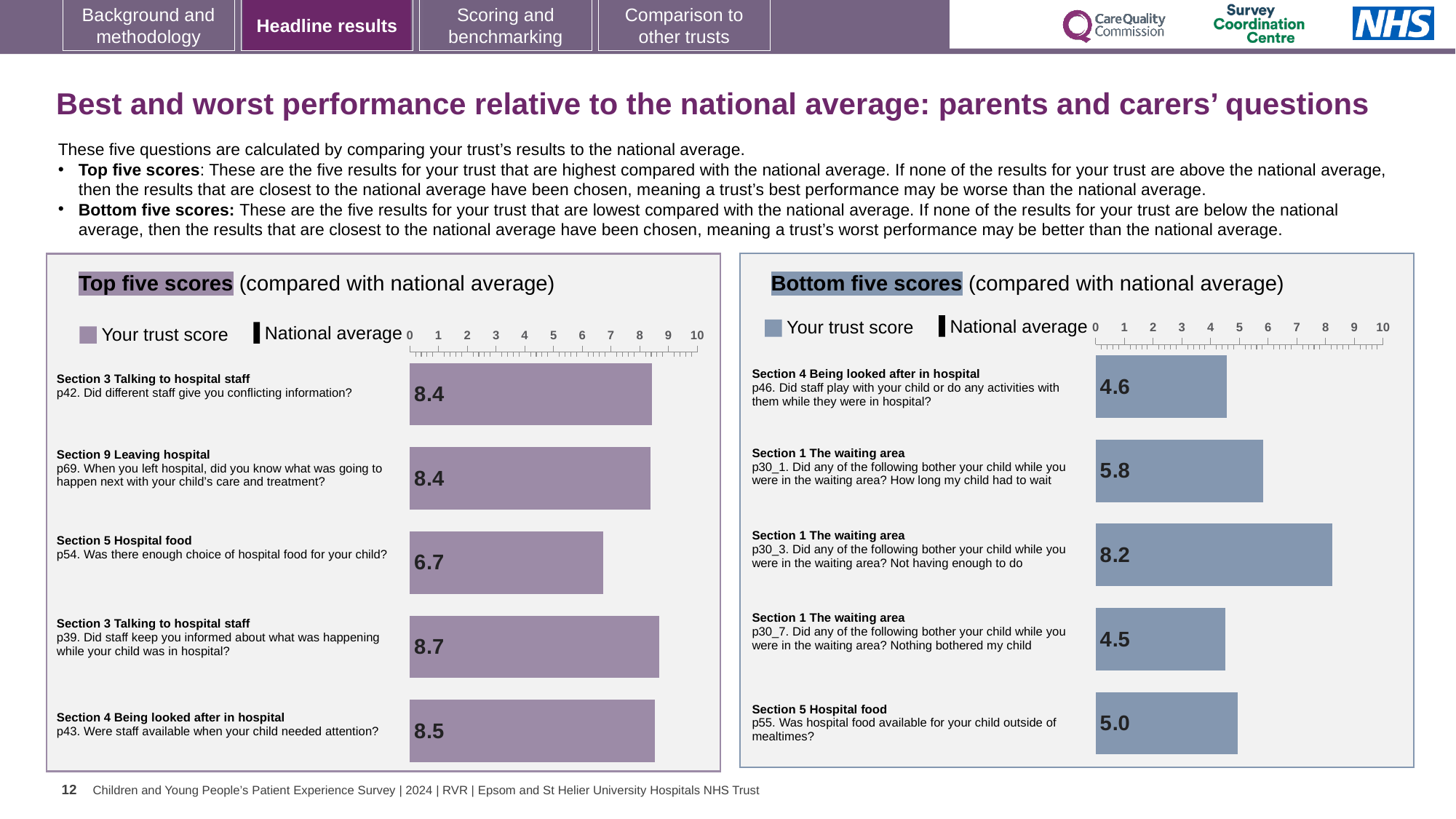
In the Top five scores chart, what is the trust score for p42 'Did different staff give you conflicting information?' 8.4 In the Top five scores chart, which question has the highest trust score? p39. Did staff keep you informed about what was happening while your child was in hospital? In the Top five scores chart, what is the difference between the highest score (p39) and the lowest score (p54)? 2.0 In the Top five scores chart, what is the trust score for p54 'Was there enough choice of hospital food for your child?' 6.7 In the Bottom five scores chart, which question has the lowest trust score? p30_7. Nothing bothered my child What type of chart is used in the Top five scores panel? bar chart In the Bottom five scores chart, what is the difference between the score for p30_3 and the score for p30_7? 3.7 How many questions are shown in the Bottom five scores chart? 5 In the Bottom five scores chart, which has the larger trust score: p30_1 'How long my child had to wait' or p55 'Was hospital food available outside of mealtimes?' p30_1 In the Bottom five scores chart, what is the trust score for p30_3 'Not having enough to do'? 8.2 In the Bottom five scores chart, what is the trust score for p55 'Was hospital food available for your child outside of mealtimes?' 5.0 In the Top five scores chart, is the trust score for p54 'Was there enough choice of hospital food for your child?' greater or less than 7? less